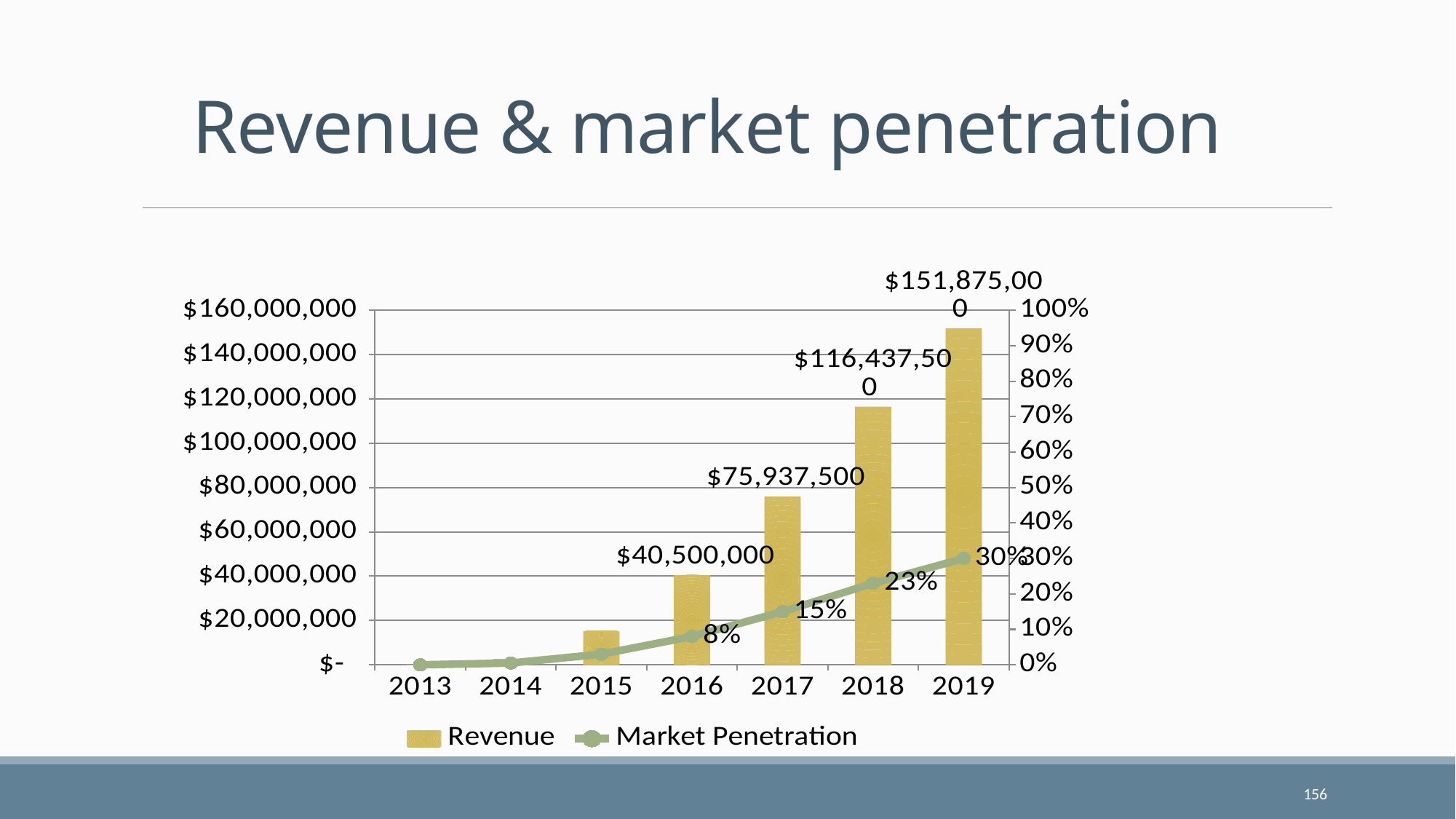
How many years are shown on the x axis? 7 How many series does the legend list? 2 Which year has the highest Revenue? 2019 Which is larger, the Revenue for 2016 or the Revenue for 2017? 2017 What is the Market Penetration value for 2016? 8% What is the Revenue value for 2019? $151,875,000 What is the difference in Revenue between 2018 and 2017? $40,500,000 What is the Revenue value for 2017? $75,937,500 What is the difference in Market Penetration between 2019 and 2016? 22% Does Market Penetration rise or fall from 2013 to 2019? rise What is the Market Penetration value for 2018? 23% Is the Revenue for 2015 greater or less than $20,000,000? less